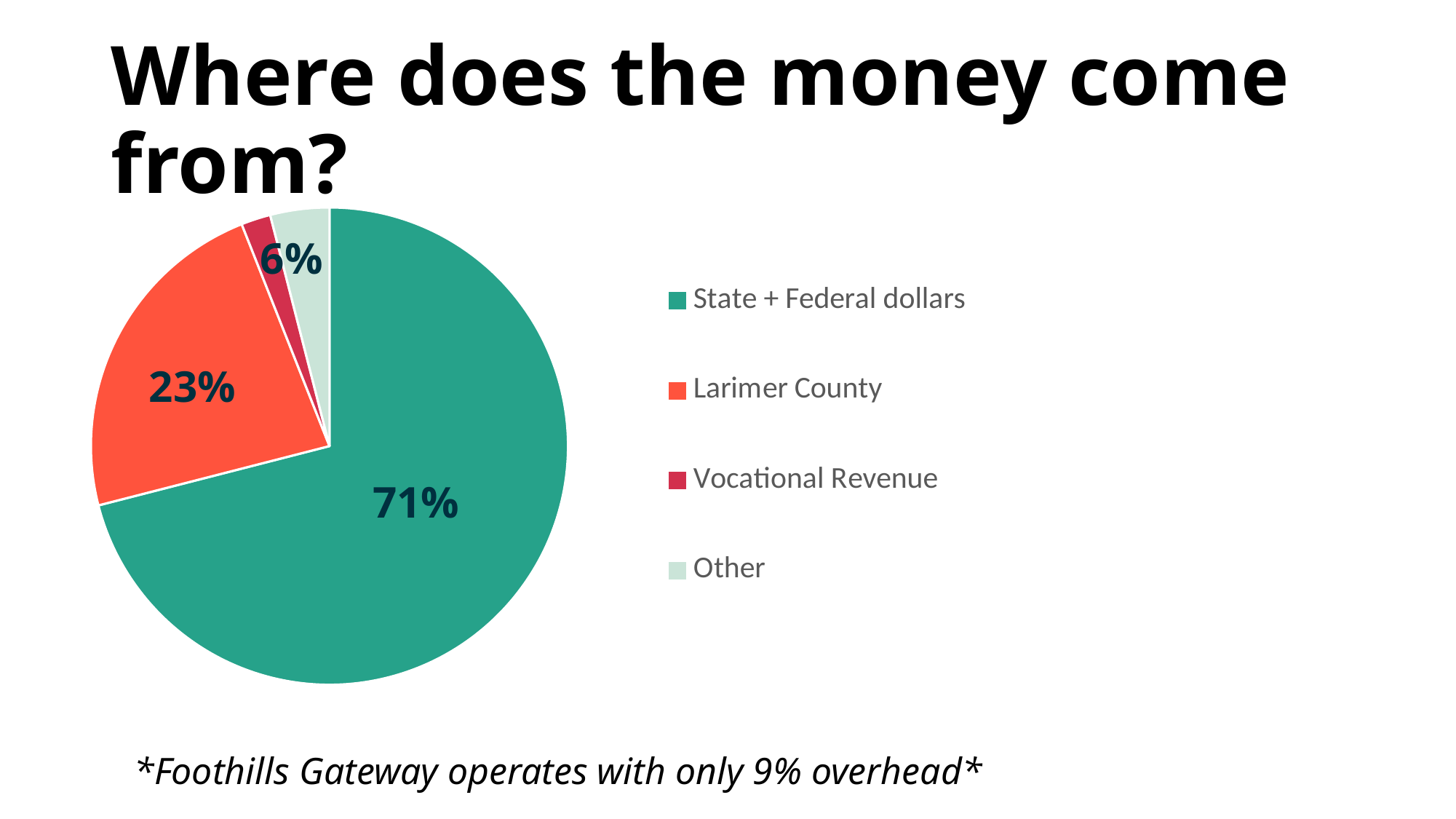
What kind of chart is shown on the slide? pie chart Which category has the largest slice of the pie? State + Federal dollars What colour is the Larimer County slice in the pie chart? orange-red What is the title of the slide containing the pie chart? Where does the money come from? What is the value shown for Larimer County? 23% How many percentage points larger is State + Federal dollars than Larimer County? 48 What share of the pie does State + Federal dollars represent? 71% How many categories does the pie chart have? 4 Which category has the smallest slice of the pie? Vocational Revenue Which is larger, the Larimer County slice or the Other slice? Larimer County